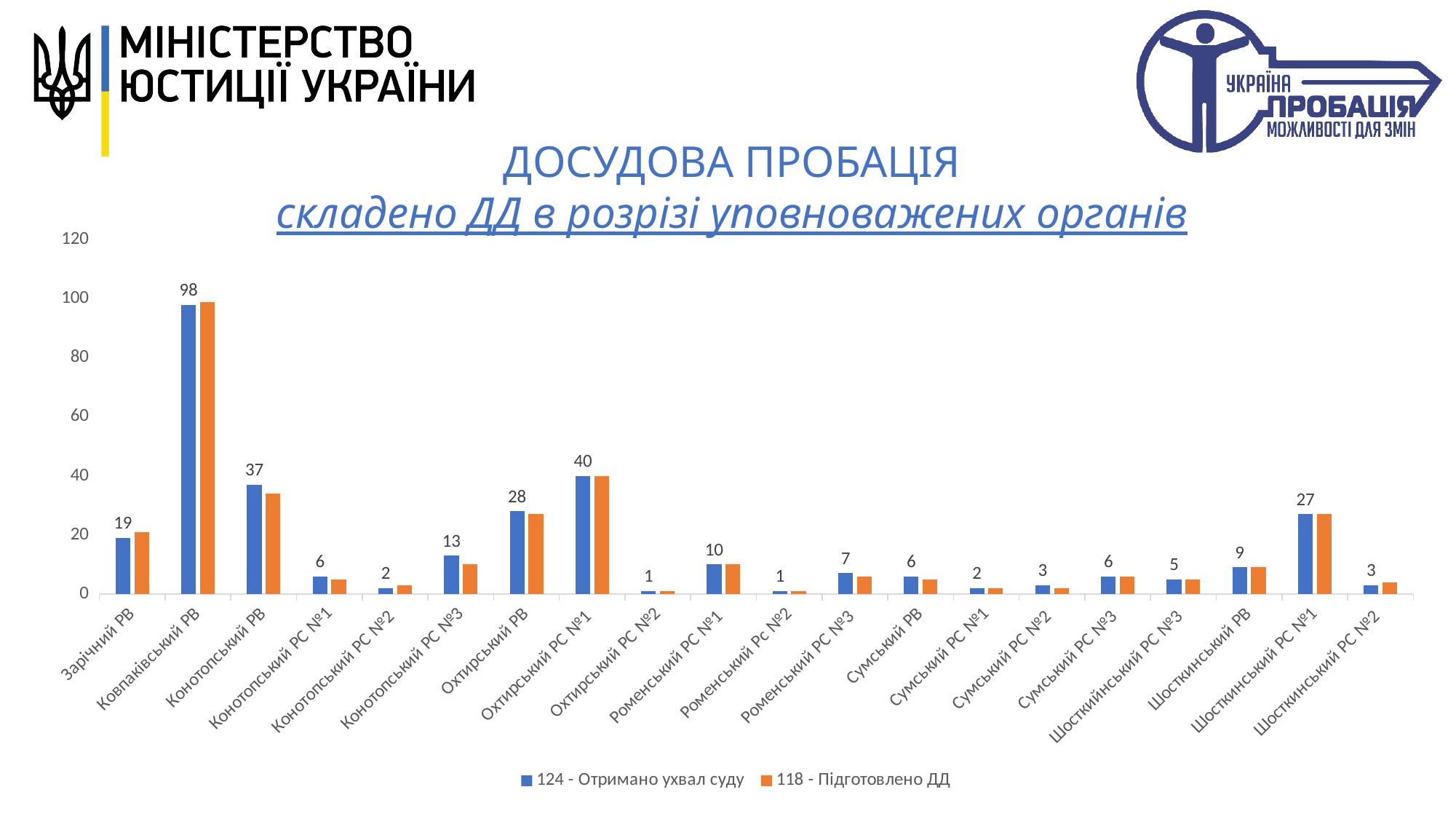
What type of chart is shown on the slide? bar chart What is the labelled value for Охтирський РС №1? 40 Is the value of the orange bar (118 - Підготовлено ДД) for Ковпаківський РВ greater or less than 80? greater Which has the larger labelled value, Охтирський РС №1 or Конотопський РВ? Охтирський РС №1 How many series does the legend list? 2 What is the labelled value for Шосткинський РС №1? 27 What is the difference between the labelled values for Ковпаківський РВ and Конотопський РВ? 61 How many categories are shown on the x axis? 20 What is the name of the first series in the legend? 124 - Отримано ухвал суду What is the labelled value for Конотопський РС №3? 13 What is the labelled value for Ковпаківський РВ? 98 Which category has the highest labelled value? Ковпаківський РВ